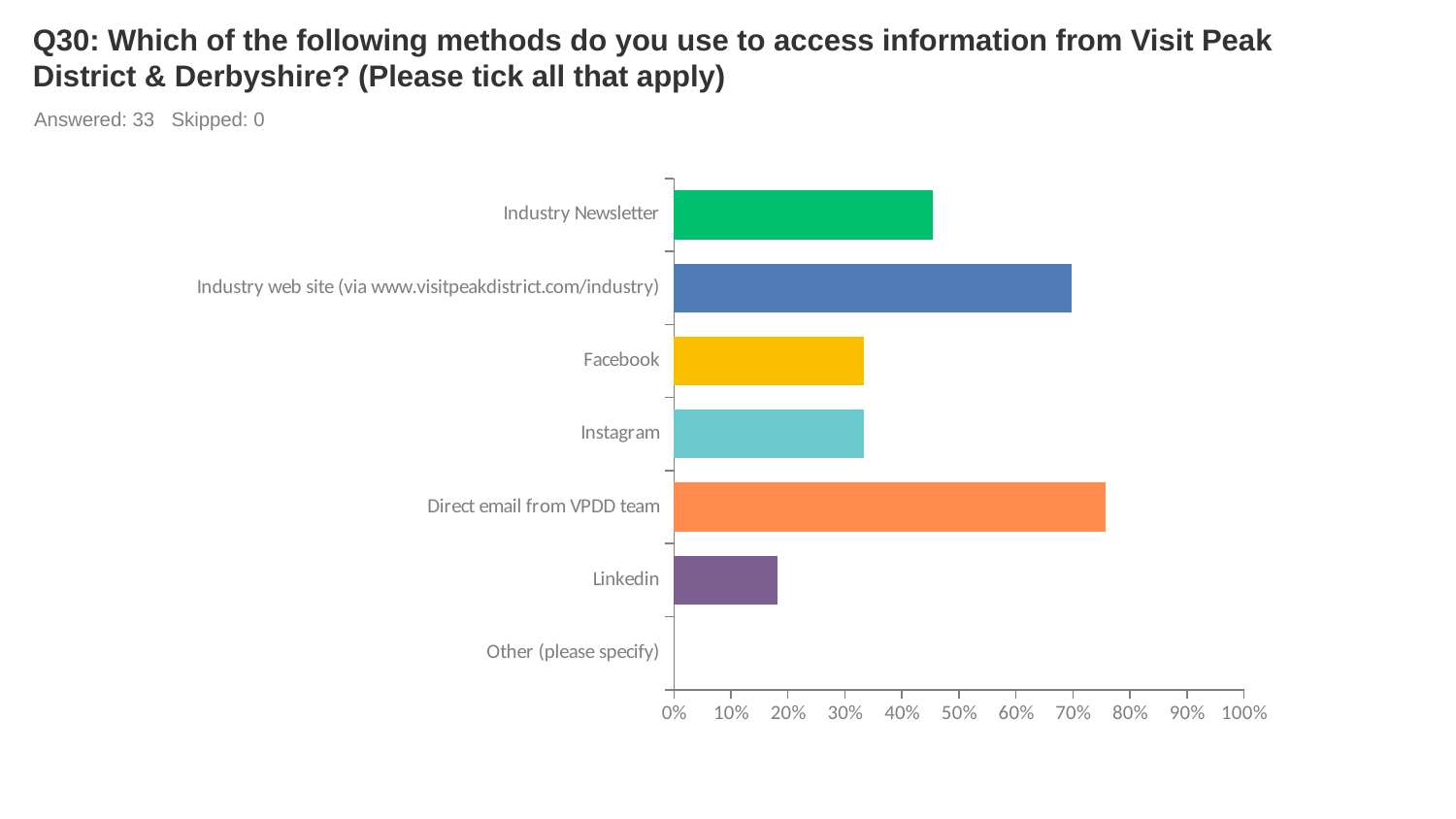
Is the value for Facebook greater or less than 40%? less Which is larger, the value for Facebook or the value for Linkedin? Facebook Which category has the lowest value in the chart? Other (please specify) Which category has the highest value in the chart? Direct email from VPDD team Is the value for Direct email from VPDD team greater or less than 70%? greater Is the value for Industry web site (via www.visitpeakdistrict.com/industry) greater or less than 60%? greater How many categories are plotted in the chart? 7 What kind of chart is shown on the slide? bar chart Which is larger, the value for Industry web site (via www.visitpeakdistrict.com/industry) or the value for Industry Newsletter? Industry web site (via www.visitpeakdistrict.com/industry) What colour is the bar for Direct email from VPDD team? orange